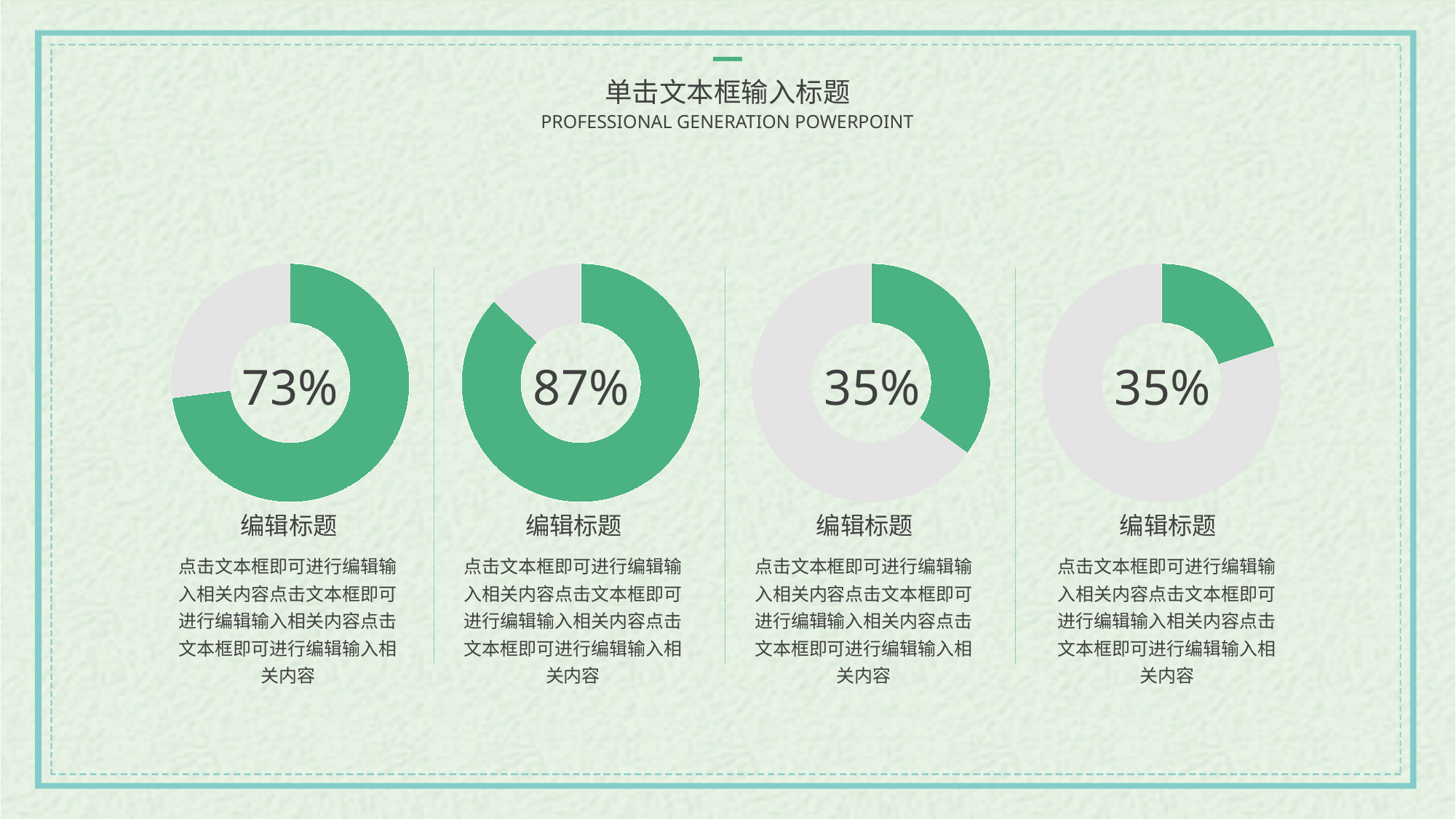
Which donut chart shows the highest percentage? the second from the left (87%) What kind of chart is used for the four charts on the slide? donut chart How many of the donut charts display a value of 35%? 2 What percentage is shown in the rightmost donut chart? 35% How many donut charts are shown on the slide? 4 What percentage is shown in the third donut chart from the left? 35% What is the difference between the percentage in the leftmost donut chart and the percentage in the third donut chart from the left? 38 percentage points What percentage is shown in the second donut chart from the left? 87% What percentage is shown in the leftmost donut chart? 73% What colour is the filled (value) portion of each donut chart? green What is the difference between the percentage in the second donut chart from the left and the percentage in the leftmost donut chart? 14 percentage points Which is larger, the percentage in the leftmost donut chart or the one in the second donut chart from the left? the second from the left (87%)